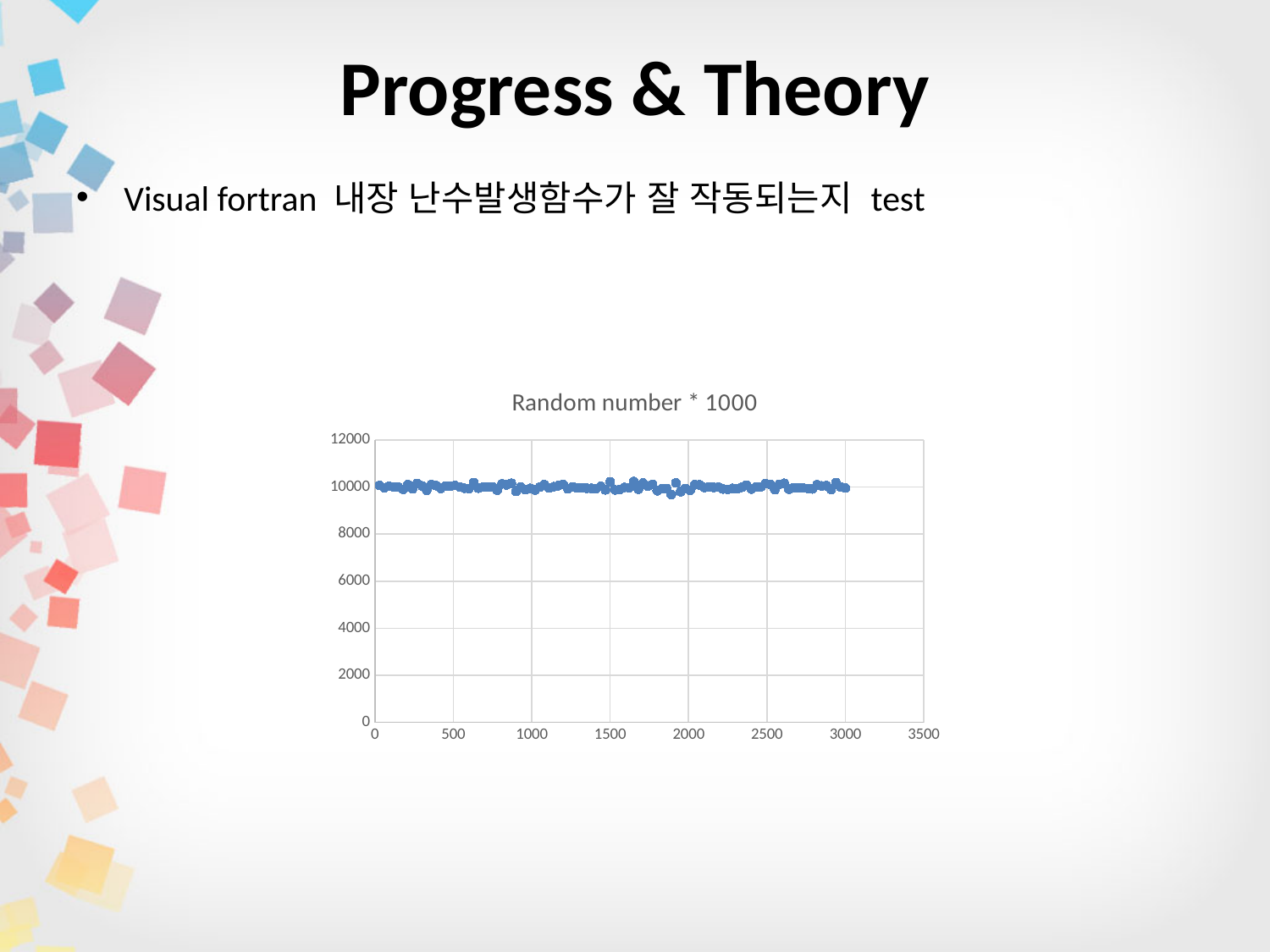
What kind of chart is shown on the slide? scatter chart What is the highest value shown on the y axis of the chart? 12000 Around which y-axis gridline value do the plotted points cluster? 10000 Are the plotted values greater or less than 12000? less Do the plotted values rise, fall, or stay roughly constant as the x value increases from 0 to 3000? stay roughly constant What is the highest value shown on the x axis of the chart? 3500 What is the title of the chart on the slide? Random number * 1000